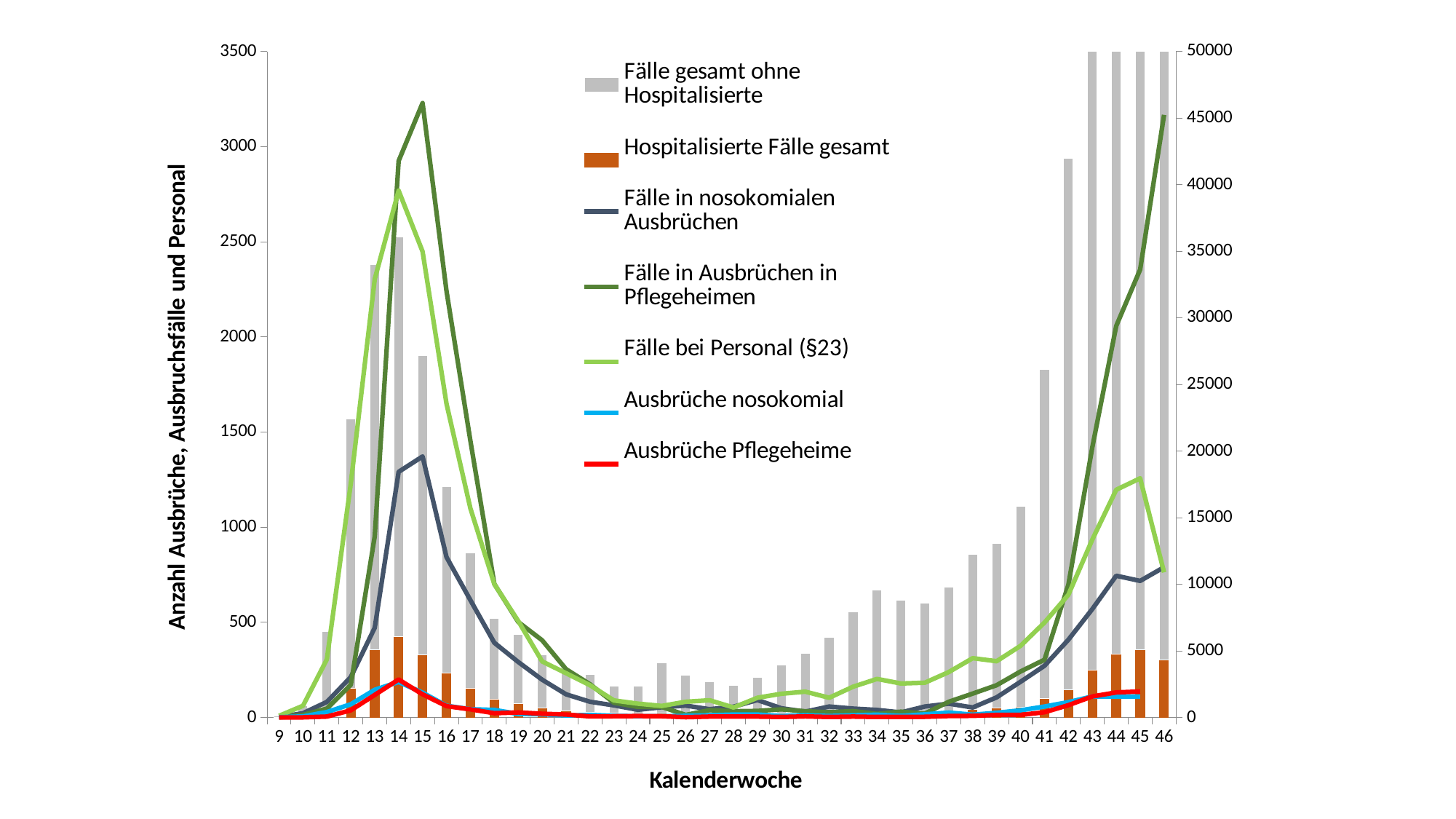
In which calendar week does 'Fälle bei Personal (§23)' reach its highest value? 14 How many calendar weeks are shown on the x axis? 38 Which colour is used for the series 'Ausbrüche Pflegeheime'? Red How many series does the legend list? 7 What kind of chart is this? Combined bar and line chart In calendar week 46, which is larger: 'Fälle in Ausbrüchen in Pflegeheimen' or 'Fälle bei Personal (§23)'? Fälle in Ausbrüchen in Pflegeheimen Is the value of 'Fälle in nosokomialen Ausbrüchen' in calendar week 15 greater or less than 1000 on the left axis? greater What is the title of the x axis? Kalenderwoche In which calendar week does 'Fälle in nosokomialen Ausbrüchen' reach its highest value? 15 Does 'Fälle in Ausbrüchen in Pflegeheimen' rise or fall from calendar week 40 to calendar week 46? Rise Is the value of 'Fälle in Ausbrüchen in Pflegeheimen' in calendar week 15 greater or less than 3000 on the left axis? greater Is the value of 'Fälle bei Personal (§23)' in calendar week 14 greater or less than 2500 on the left axis? greater